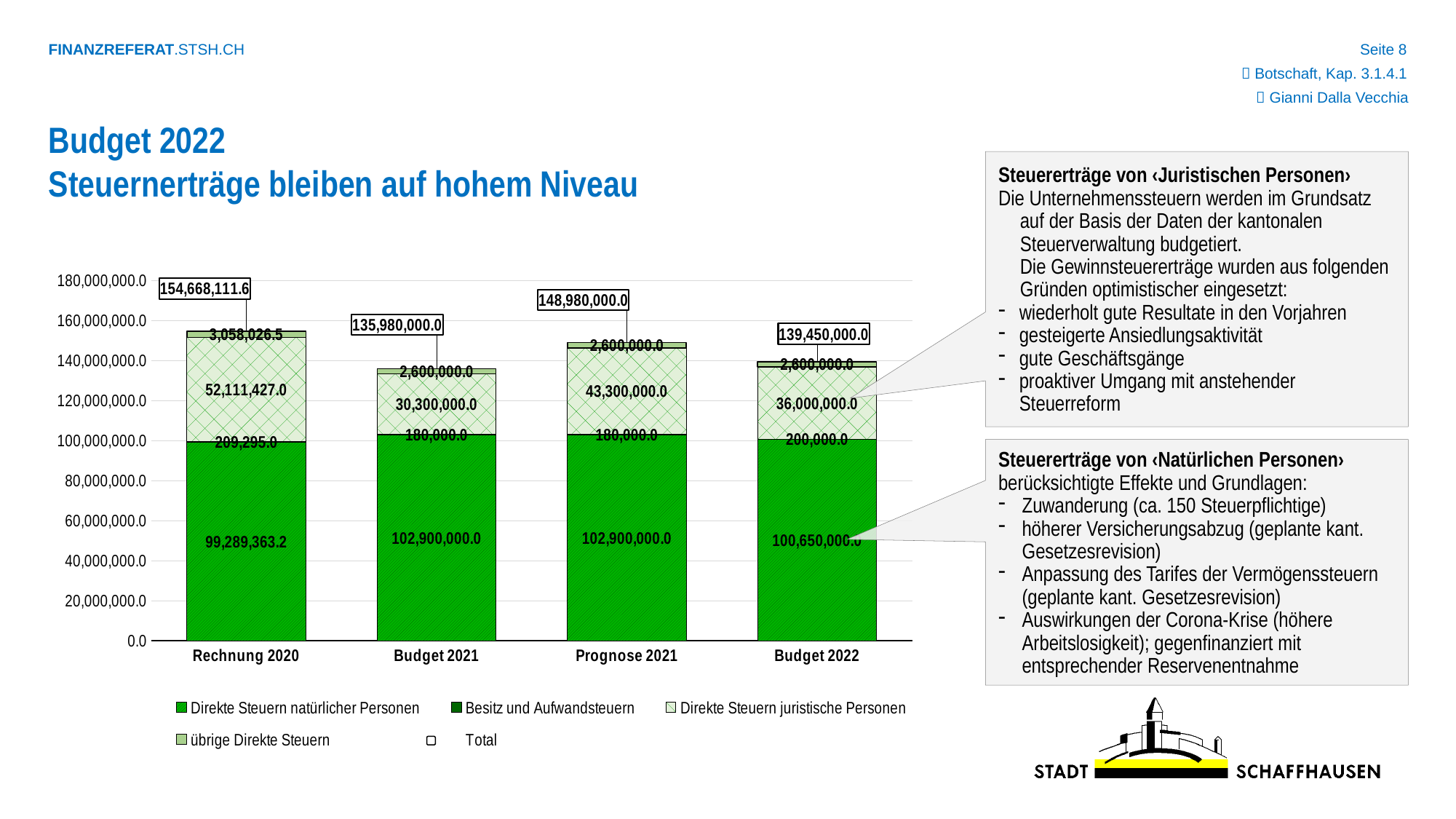
What is the difference between the total for Prognose 2021 and the total for Budget 2021? 13,000,000.0 How many categories are shown on the x axis of the chart? 4 What is the value of Direkte Steuern juristische Personen for Prognose 2021? 43,300,000.0 What is the value of Direkte Steuern natürlicher Personen for Budget 2022? 100,650,000.0 What type of chart is shown on the slide? stacked bar chart What is the total value labelled for Rechnung 2020? 154,668,111.6 What is the value of übrige Direkte Steuern for Rechnung 2020? 3,058,026.5 How many series does the chart legend list? 5 What is the value of Besitz und Aufwandsteuern for Rechnung 2020? 209,295.0 Which is larger: Direkte Steuern juristische Personen for Budget 2022 or for Budget 2021? Budget 2022 Which category has the highest total value? Rechnung 2020 Which category has the lowest total value? Budget 2021